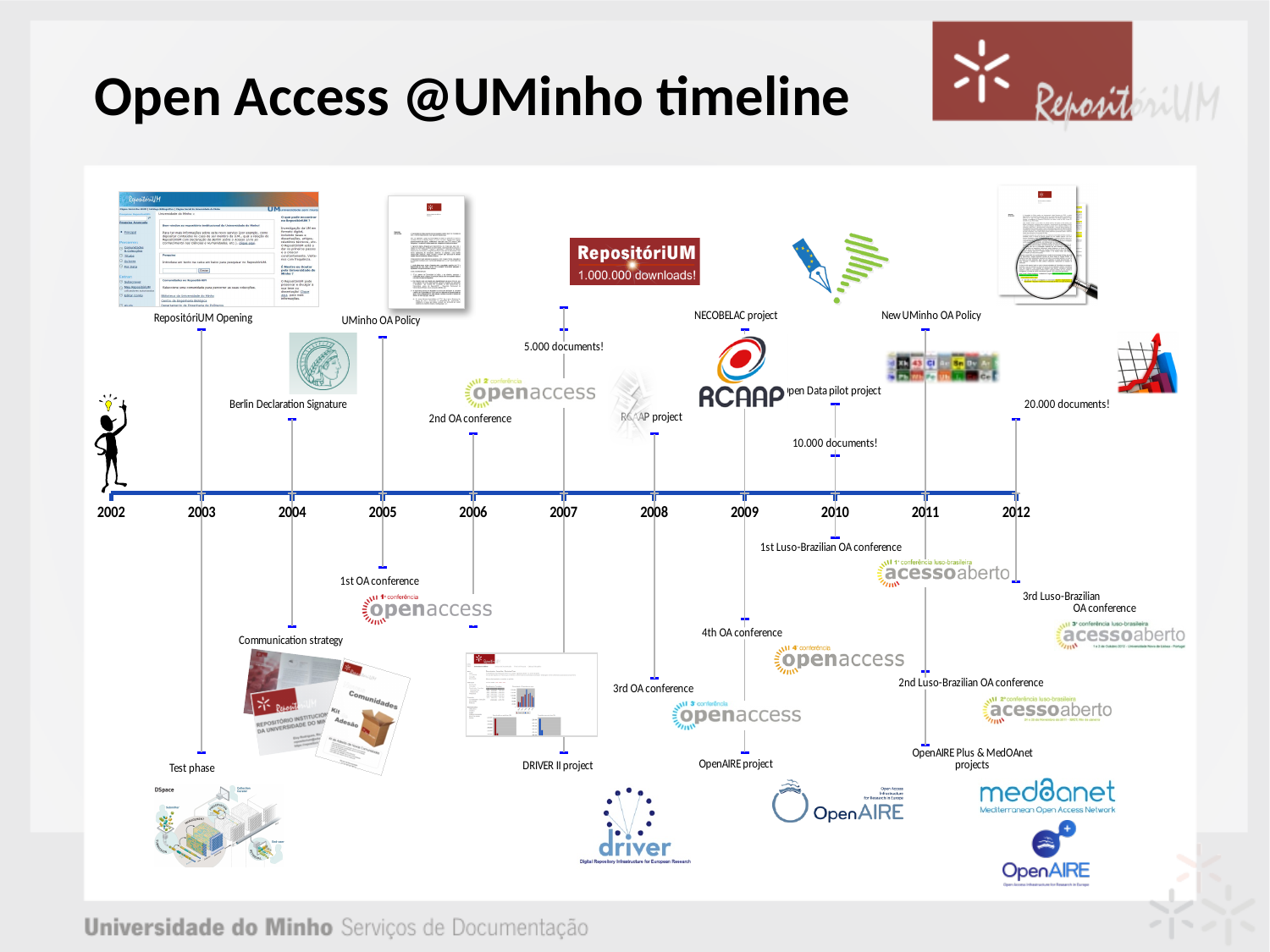
What is the last year shown on the timeline axis? 2012 In which year is the RepositóriUM Opening placed on the timeline? 2003 Which is placed earlier on the timeline, the UMinho OA Policy or the New UMinho OA Policy? UMinho OA Policy In which year is the '5.000 documents!' milestone placed on the timeline? 2007 In which year is the 1st Luso-Brazilian OA conference placed on the timeline? 2010 What is the first year shown on the timeline axis? 2002 What kind of chart is shown on the slide? Timeline In which year is the Berlin Declaration Signature placed on the timeline? 2004 Do the document-count milestones (5.000, 10.000, 20.000 documents) rise or fall along the timeline? Rise In which year is the '20.000 documents!' milestone placed on the timeline? 2012 What is the title of the slide's timeline? Open Access @UMinho timeline How many year labels are shown along the timeline axis? 11